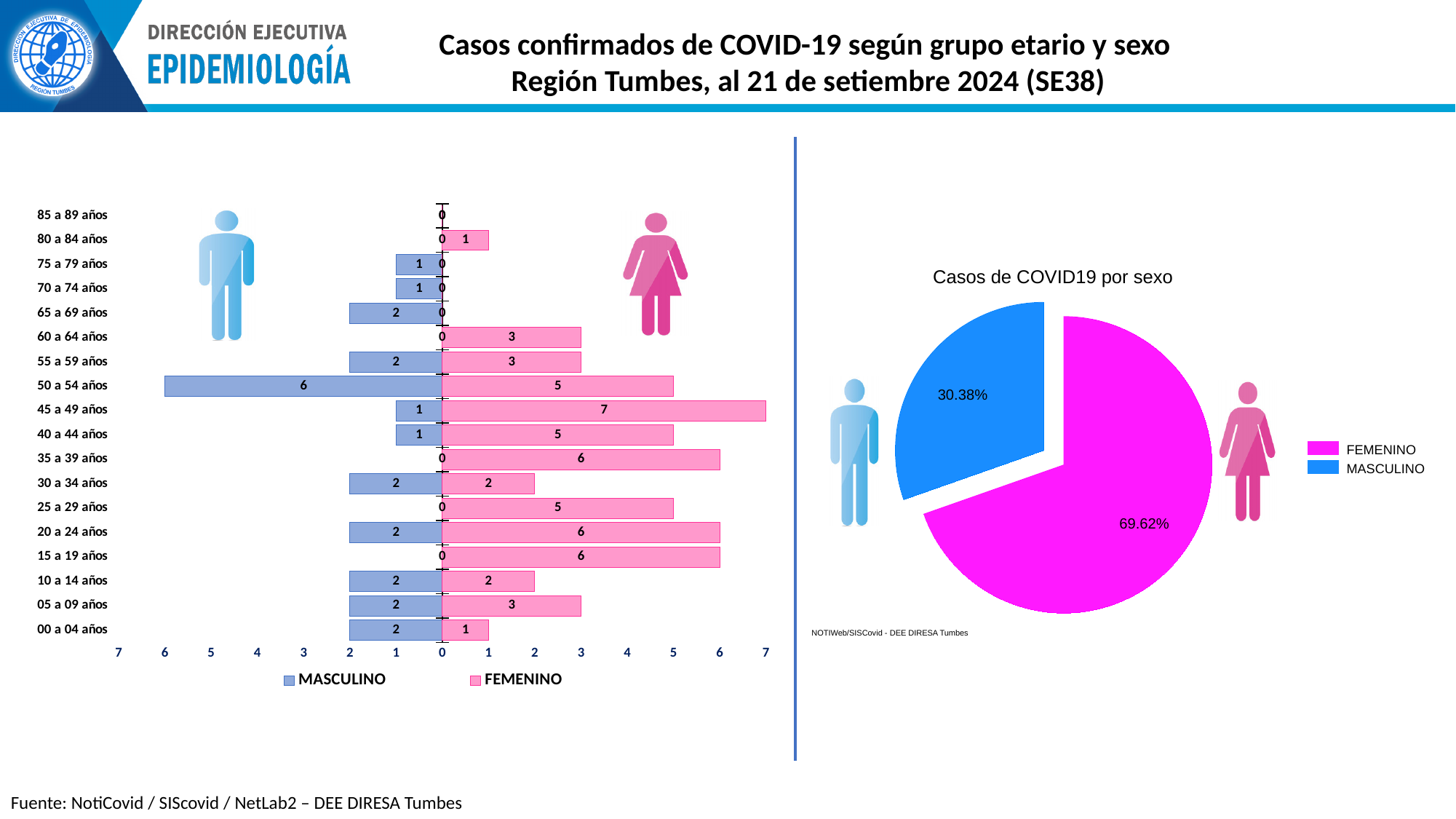
In the pie chart 'Casos de COVID19 por sexo', what share of cases is MASCULINO? 30.38% What kind of chart is the chart on the left of the slide? Bar chart In the bar chart on the left, how many age groups are listed on the vertical axis? 18 In the bar chart on the left, what is the difference between FEMENINO and MASCULINO cases in the 45 a 49 años group? 6 In the bar chart on the left, which age group has the highest number of FEMENINO cases? 45 a 49 años In the pie chart 'Casos de COVID19 por sexo', which colour represents MASCULINO? Blue In the bar chart on the left, which age group has the highest number of MASCULINO cases? 50 a 54 años In the bar chart on the left, how many MASCULINO cases are shown for the 50 a 54 años group? 6 In the bar chart on the left, how many FEMENINO cases are shown for the 45 a 49 años group? 7 In the bar chart on the left, how many series does the legend list? 2 In the pie chart 'Casos de COVID19 por sexo', what share of cases is FEMENINO? 69.62% In the bar chart on the left, which is larger for the 50 a 54 años group, MASCULINO or FEMENINO? MASCULINO